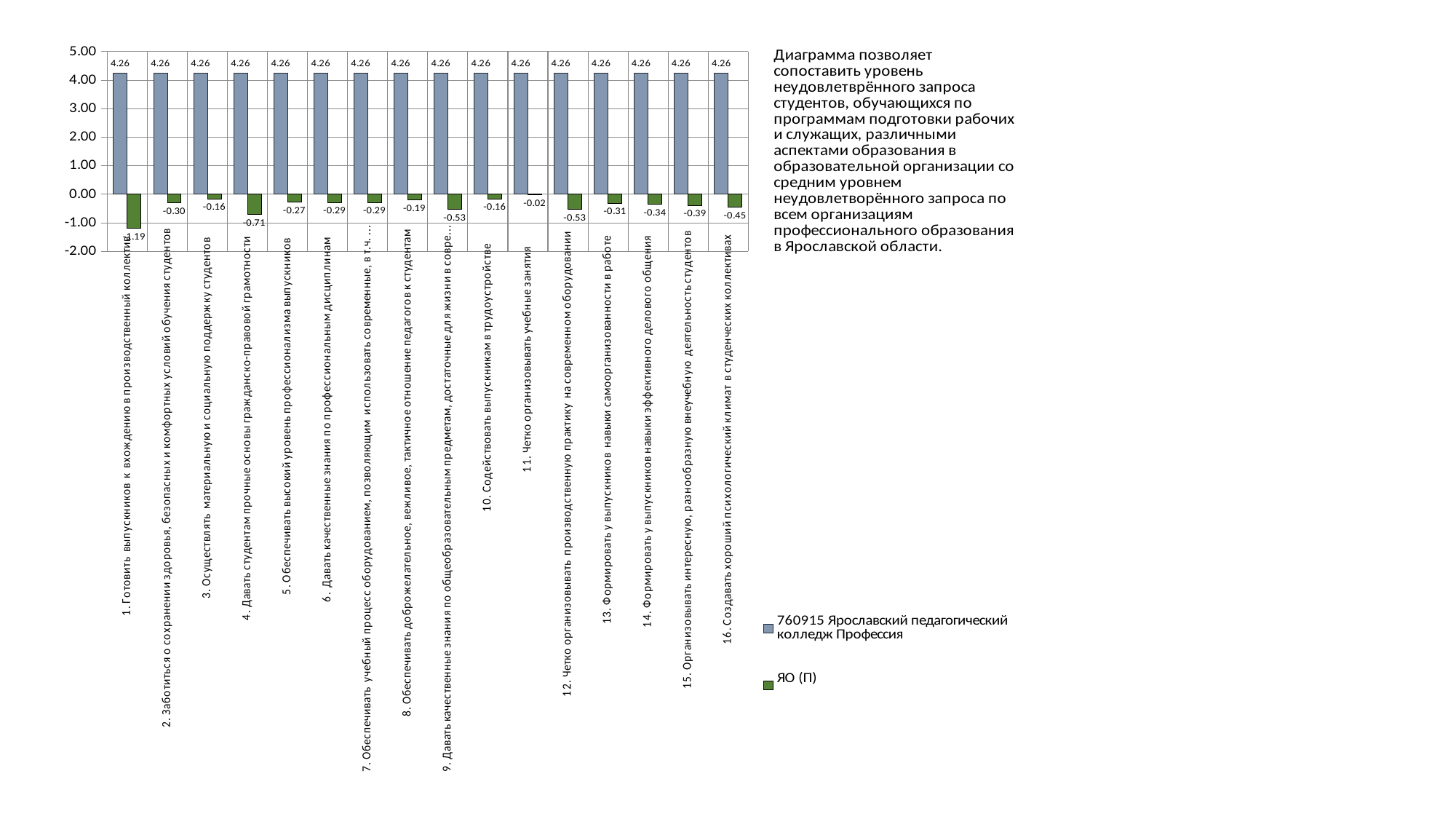
What is the value of the series '760915 Ярославский педагогический колледж Профессия' for category '4. Давать студентам прочные основы гражданско-правовой грамотности'? 4.26 How many series does the legend list? 2 What is the difference between the 'ЯО (П)' values for category 9 and category 10? 0.37 How many categories are plotted along the x axis? 16 What is the value of the series 'ЯО (П)' for category '11. Четко организовывать учебные занятия'? -0.02 What type of chart is shown on the slide? Bar chart What colour are the bars for the series 'ЯО (П)'? Green What is the value of the series 'ЯО (П)' for category '16. Создавать хороший психологический климат в студенческих коллективах'? -0.45 Which is larger for the series 'ЯО (П)': the value for category 2 or the value for category 15? Category 2 (-0.30) Which category has the highest value for the series 'ЯО (П)'? 11. Четко организовывать учебные занятия What is the value of the series 'ЯО (П)' for category '4. Давать студентам прочные основы гражданско-правовой грамотности'? -0.71 Which category has the lowest value for the series 'ЯО (П)'? 1. Готовить выпускников к вхождению в производственный коллектив